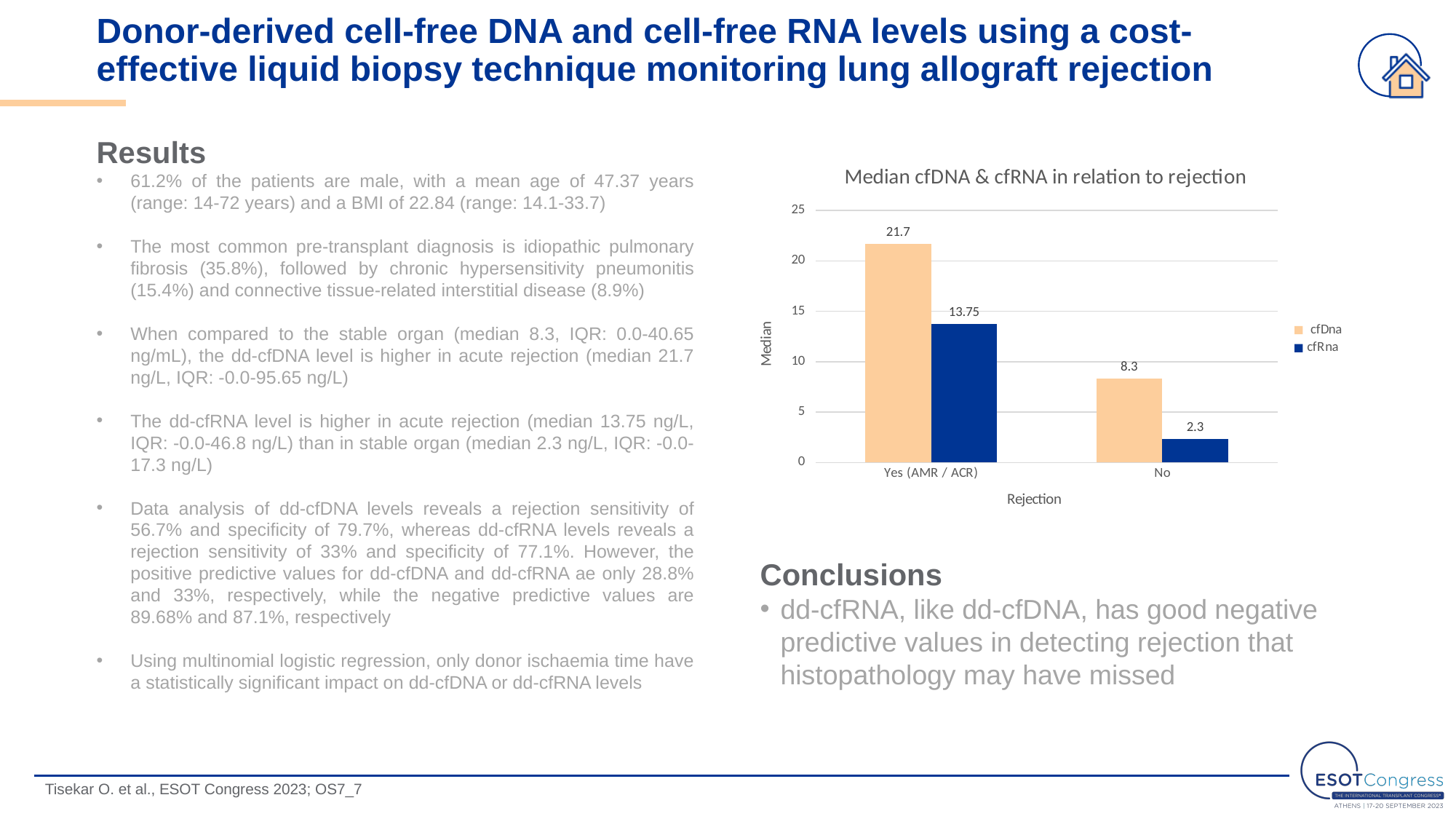
What is the median cfRna value for the 'No' rejection category? 2.3 Which bar in the chart has the lowest value? cfRna, No What kind of chart is shown on the slide? Bar chart What is the difference between the cfDna values for 'Yes (AMR / ACR)' and 'No'? 13.4 What is the median cfRna value for the 'Yes (AMR / ACR)' rejection category? 13.75 How many series does the legend list? 2 Which bar in the chart has the highest value? cfDna, Yes (AMR / ACR) Which is larger for the 'No' category: cfDna or cfRna? cfDna What is the median cfDna value for the 'No' rejection category? 8.3 What is the title of the chart? Median cfDNA & cfRNA in relation to rejection What is the median cfDna value for the 'Yes (AMR / ACR)' rejection category? 21.7 How many rejection categories are shown on the x axis? 2